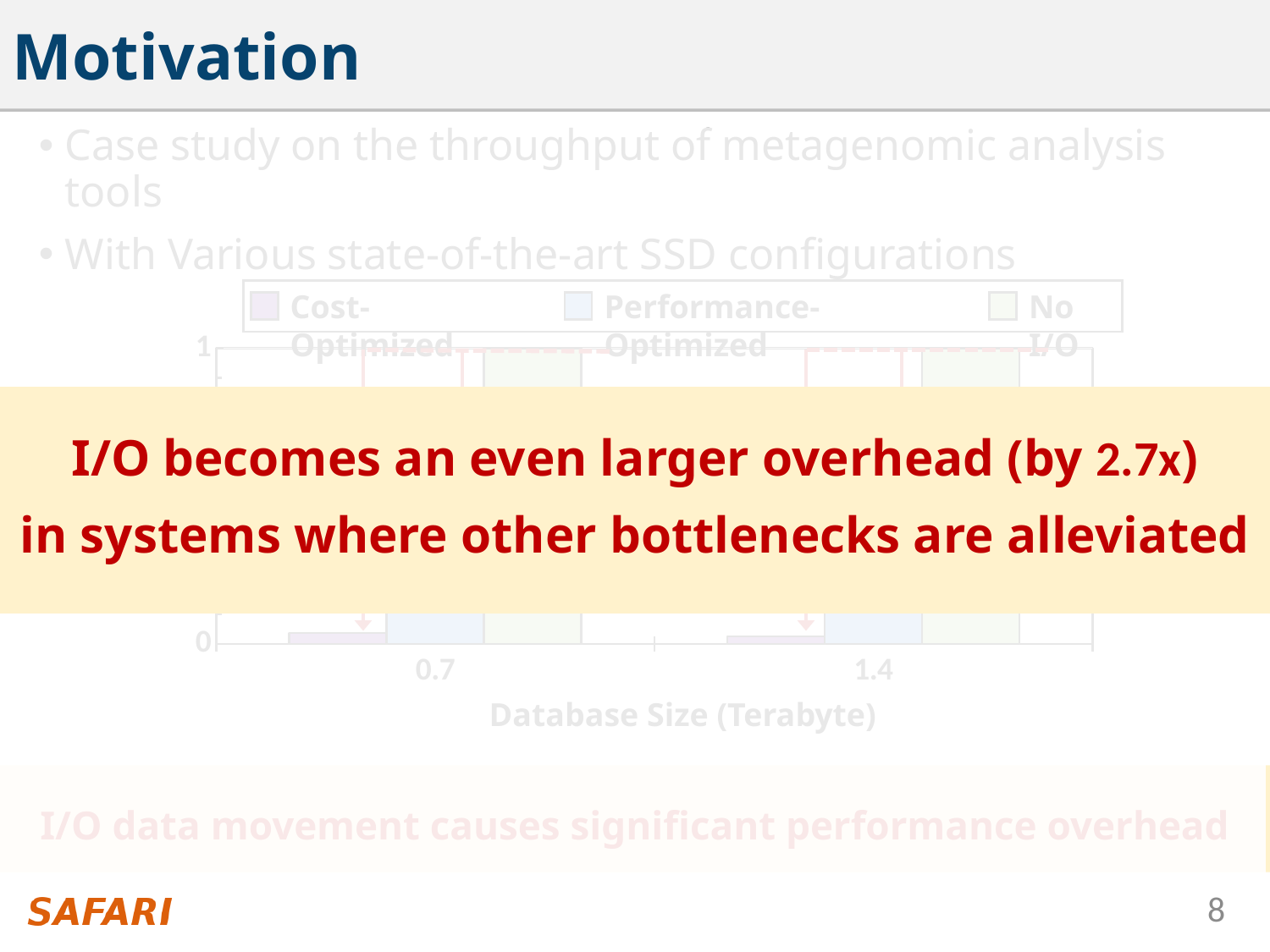
What kind of chart is shown on the slide? bar chart How many series does the chart's legend list? 3 Is the value for Cost-Optimized at database size 0.7 greater or less than 1? less What is the title of the x axis of the chart? Database Size (Terabyte) Which series are listed in the chart's legend? Cost-Optimized, Performance-Optimized, No I/O How many database size categories are shown on the x axis of the chart? 2